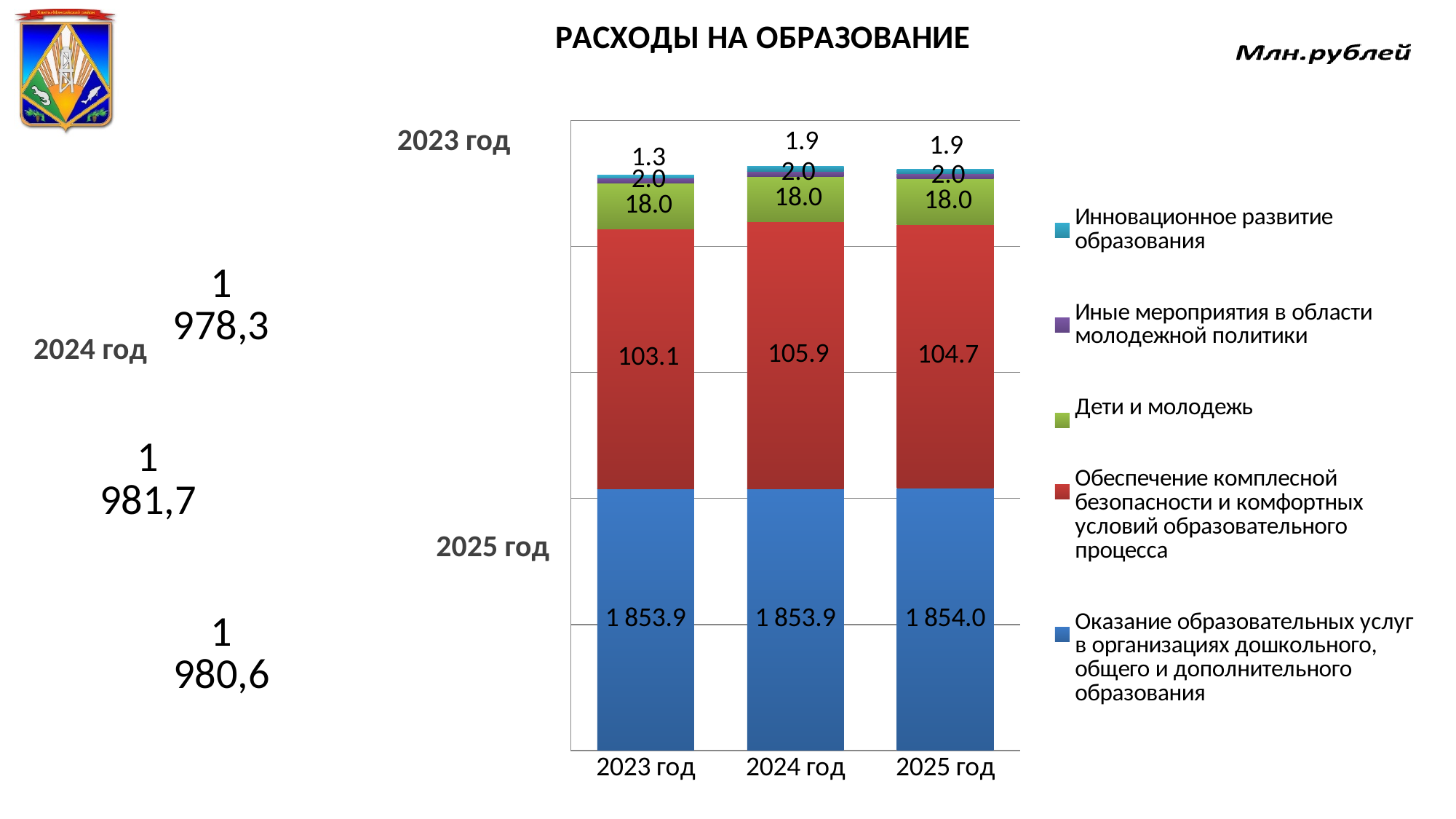
What is the title of the chart? РАСХОДЫ НА ОБРАЗОВАНИЕ What is the difference between the "Обеспечение комплесной безопасности и комфортных условий образовательного процесса" values for 2024 год and 2023 год? 2.8 What is the value for "Инновационное развитие образования" in 2023 год? 1.3 What is the value for "Оказание образовательных услуг в организациях дошкольного, общего и дополнительного образования" in 2025 год? 1 854.0 How many years (categories) are shown on the x axis? 3 How many series does the legend list? 5 What is the total of the stacked bar for 2023 год? 1 978,3 What is the value for "Обеспечение комплесной безопасности и комфортных условий образовательного процесса" in 2024 год? 105.9 What is the value for "Дети и молодежь" in 2025 год? 18.0 In which year is the value for "Обеспечение комплесной безопасности и комфортных условий образовательного процесса" the highest? 2024 год In which year is the value for "Инновационное развитие образования" the lowest? 2023 год What type of chart is shown on the slide? Stacked bar chart